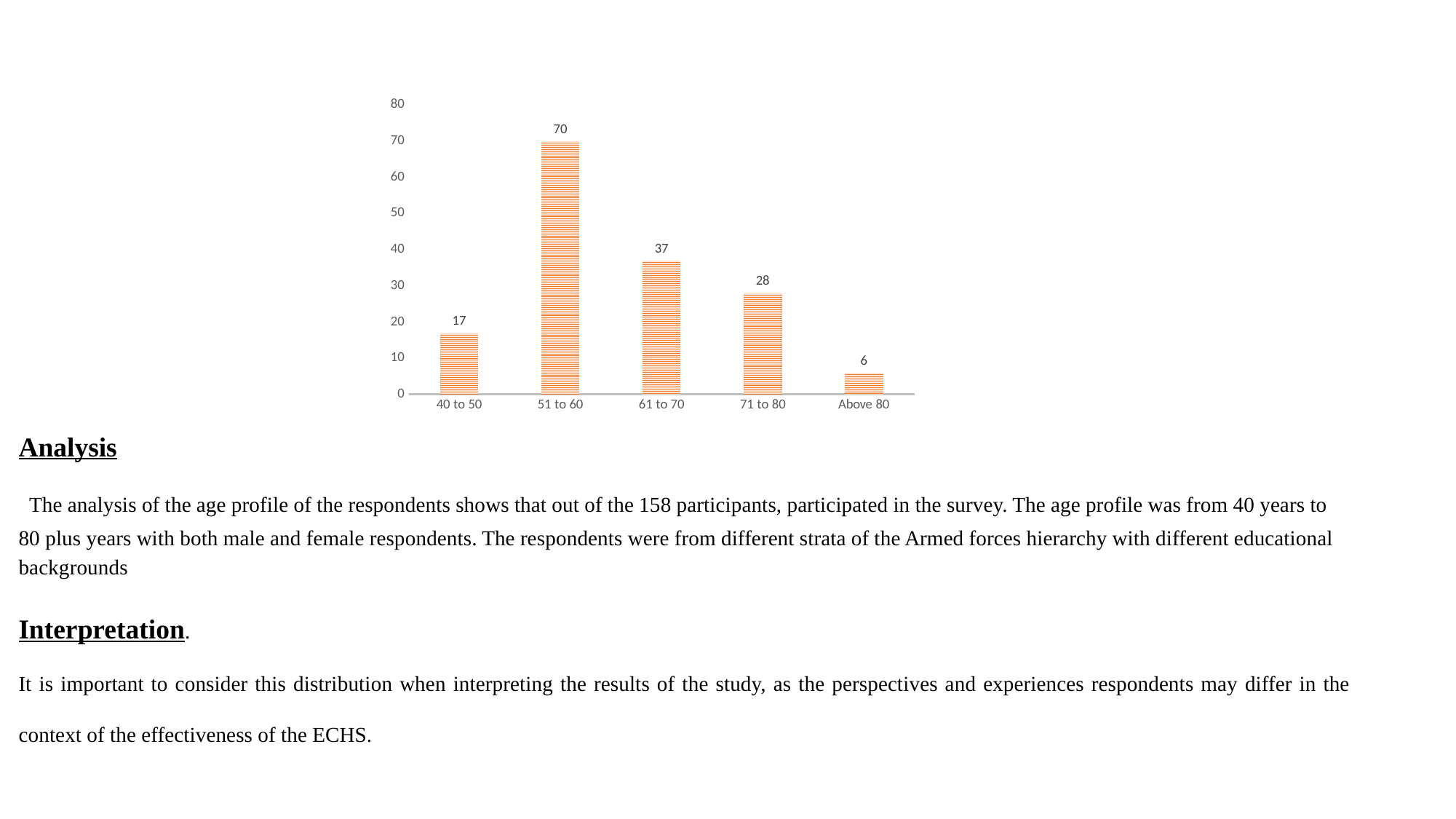
What is the difference between the values for 71 to 80 and Above 80? 22 What is the value for the 40 to 50 age group? 17 How many age groups are shown on the chart? 5 Which is larger, the value for 61 to 70 or the value for 71 to 80? 61 to 70 What is the value for the 51 to 60 age group? 70 What kind of chart is shown on the slide? bar chart Is the value for 40 to 50 greater or less than 20? less What is the difference between the values for 51 to 60 and 61 to 70? 33 What is the value for the Above 80 age group? 6 Which age group has the lowest value? Above 80 Do the values rise or fall from 51 to 60 through Above 80? fall Which age group has the highest value? 51 to 60